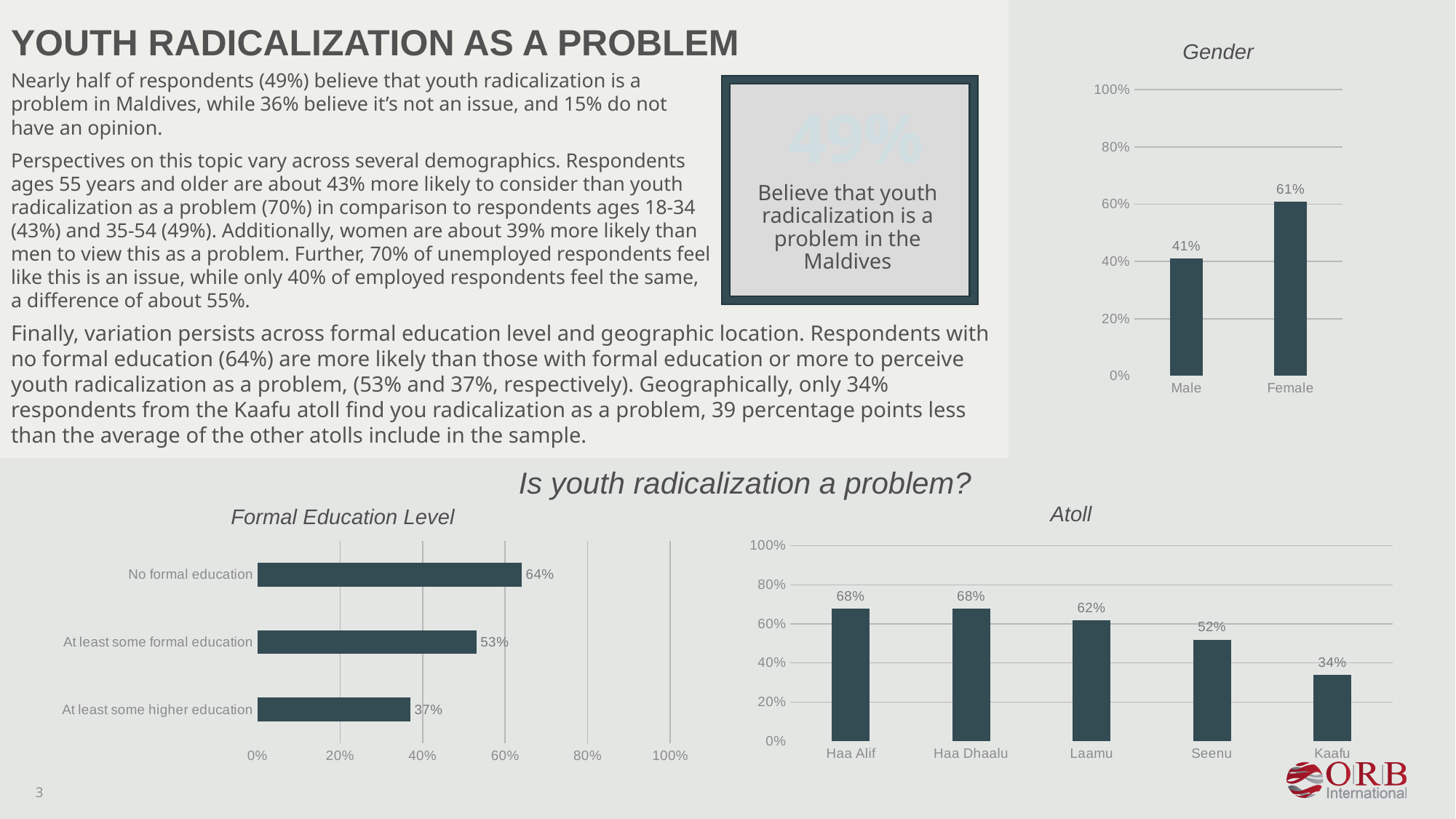
In the Gender chart, what is the value for Female? 61% In the Formal Education Level chart, which category has the lowest value? At least some higher education What kind of chart is the Formal Education Level chart? Bar chart In the Gender chart, what is the value for Male? 41% In the Atoll chart, how many atolls are shown? 5 In the Atoll chart, which atoll has the lowest value? Kaafu In the Atoll chart, is the value for Seenu larger or smaller than the value for Laamu? Smaller In the Formal Education Level chart, what is the value for No formal education? 64% In the Atoll chart, do the values rise or fall from left to right? Fall In the Formal Education Level chart, what is the difference between No formal education and At least some higher education? 27 percentage points In the Atoll chart, what is the value for Kaafu? 34% In the Gender chart, what is the difference between the Female and Male values? 20 percentage points